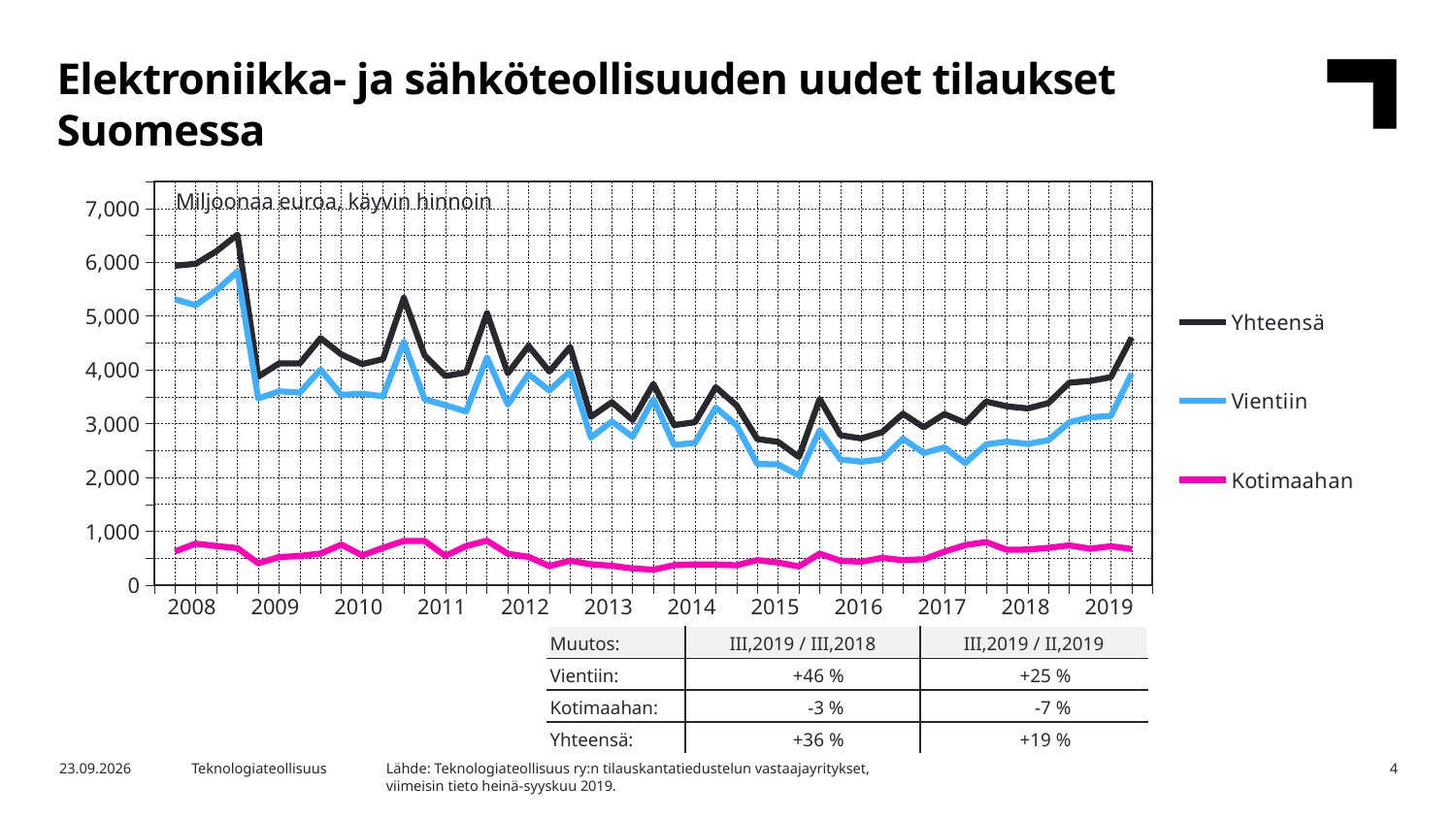
How many series does the chart legend list? 3 Is the peak value of Yhteensä in 2008 greater or less than 6,000? greater In which year does the Yhteensä series reach its highest peak? 2008 How many years are labelled on the x axis of the chart? 12 What kind of chart is shown on the slide? Line chart Which series has the lowest values throughout the chart? Kotimaahan Is the lowest Vientiin value around 2015 greater or less than 3,000? less Are the Kotimaahan values greater or less than 1,000 across the whole chart? less Which series has the highest values throughout the chart? Yhteensä What are the three series listed in the chart legend? Yhteensä, Vientiin, Kotimaahan Does the Yhteensä series generally rise or fall from 2008 to 2015? fall What unit is stated in the chart's subtitle? Miljoonaa euroa, käyvin hinnoin